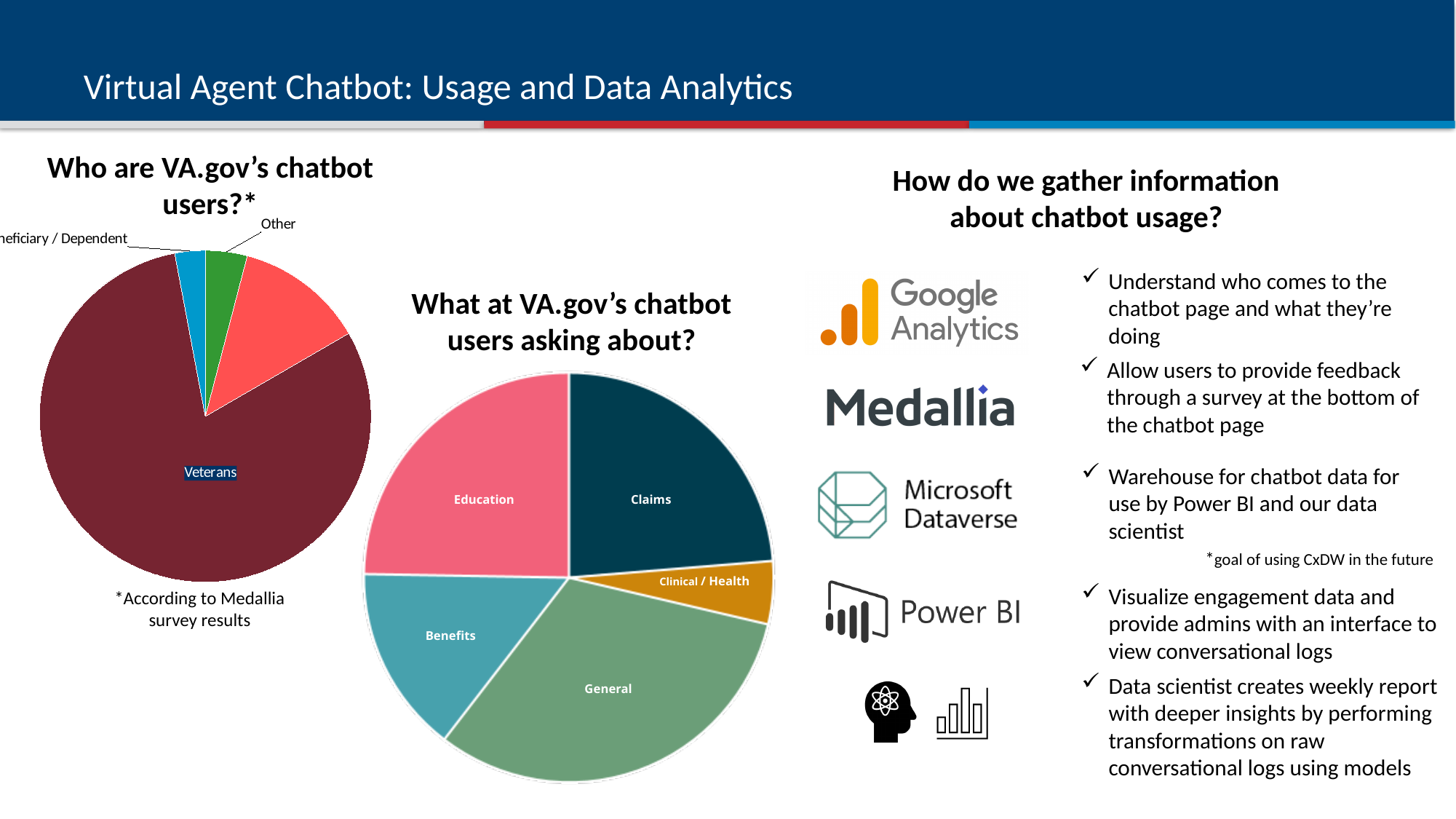
In the "What at VA.gov's chatbot users asking about?" chart, which slice is larger, Claims or Clinical / Health? Claims How many slices does the "Who are VA.gov's chatbot users?*" chart have? 4 What kind of chart is the "Who are VA.gov's chatbot users?*" chart? pie chart According to the footnote, what is the source of the data in the "Who are VA.gov's chatbot users?*" chart? Medallia survey results In the "Who are VA.gov's chatbot users?*" chart, which slice is larger, Veterans or Other? Veterans In the "What at VA.gov's chatbot users asking about?" chart, which category has the largest slice? General In the "What at VA.gov's chatbot users asking about?" chart, which category has the smallest slice? Clinical / Health What colour is the General slice in the "What at VA.gov's chatbot users asking about?" chart? green In the "What at VA.gov's chatbot users asking about?" chart, which slice is larger, General or Benefits? General In the "Who are VA.gov's chatbot users?*" chart, which category has the largest slice? Veterans What kind of chart is the "What at VA.gov's chatbot users asking about?" chart? pie chart How many slices does the "What at VA.gov's chatbot users asking about?" chart have? 5